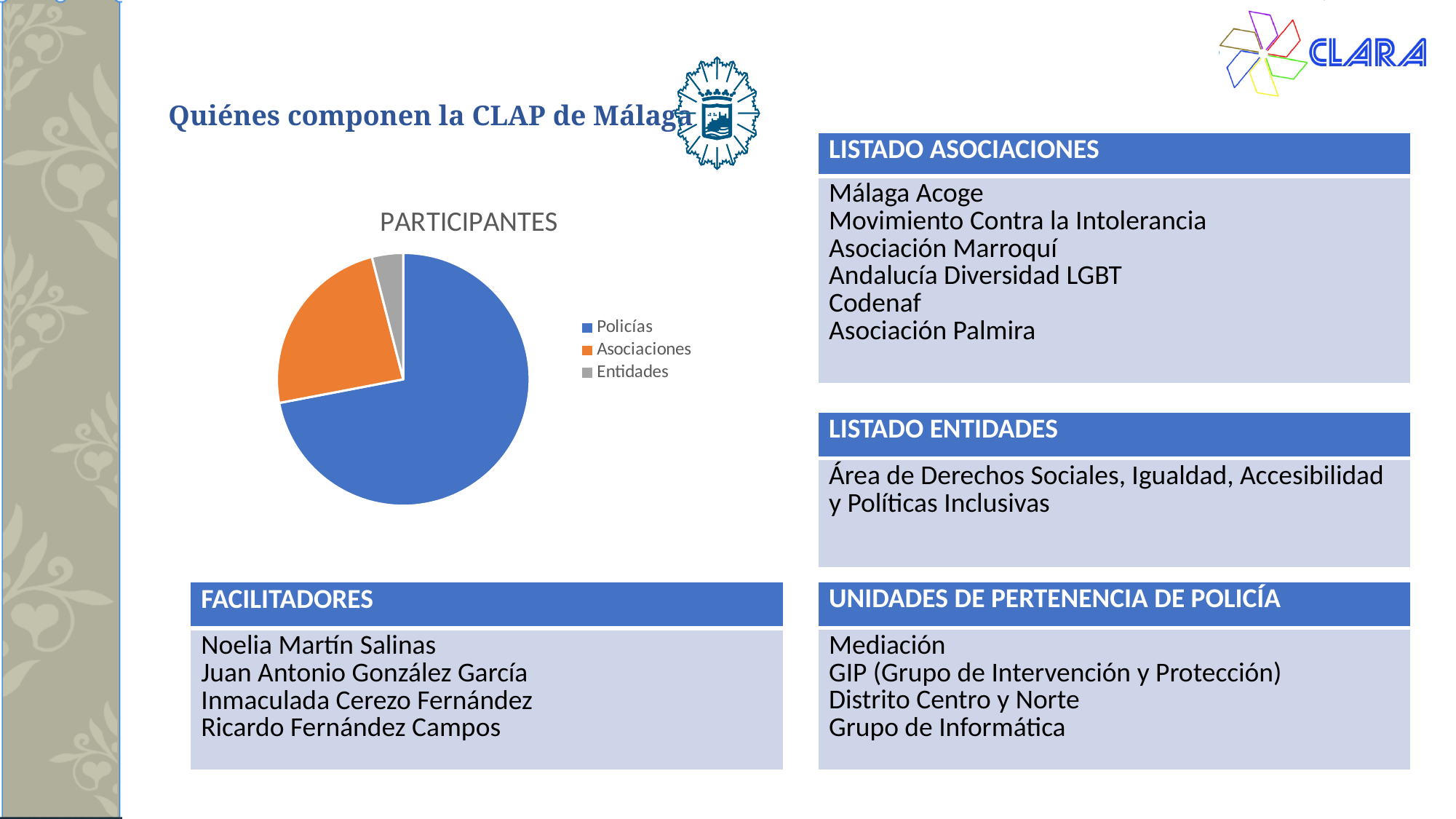
Which category has the smallest slice of the pie chart? Entidades How many entries does the chart legend list? 3 Which slice is larger, Asociaciones or Entidades? Asociaciones What is the title of the chart? PARTICIPANTES Which category has the largest slice of the pie chart? Policías What kind of chart is shown on the slide? pie chart Which colour represents Asociaciones in the pie chart? orange Which slice is larger, Policías or Asociaciones? Policías How many slices does the pie chart have? 3